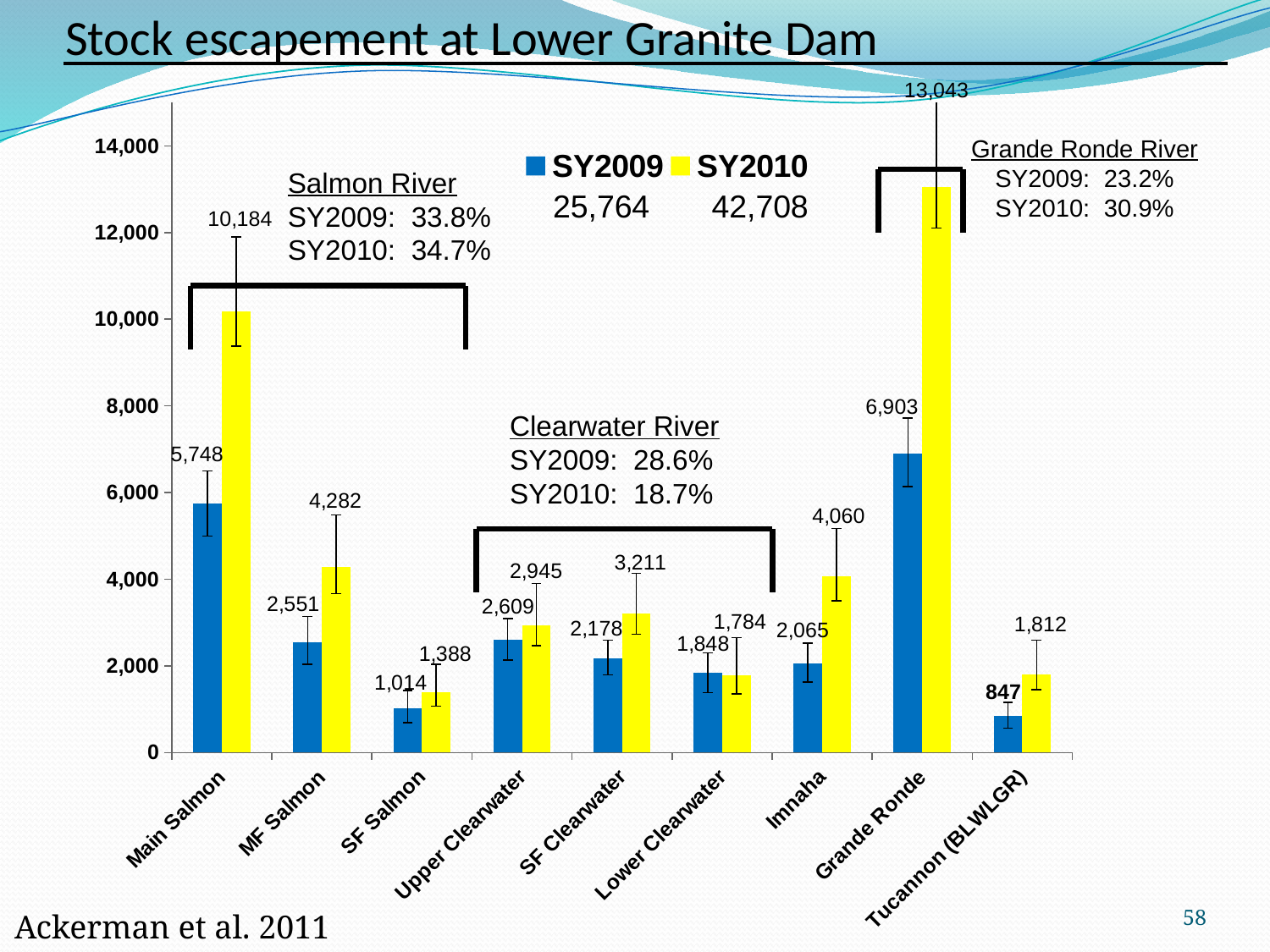
How many series does the legend list? 2 Is the SY2010 value for MF Salmon greater or less than 4,000? greater What is the difference between the SY2010 and SY2009 values for Main Salmon? 4,436 How many categories are shown on the x axis? 9 What is the SY2009 value for Tucannon (BLWLGR)? 847 Which category has the lowest SY2009 value? Tucannon (BLWLGR) What is the SY2009 value for Main Salmon? 5,748 Which category has the highest SY2010 value? Grande Ronde What is the SY2010 value for Imnaha? 4,060 Which is larger for Lower Clearwater, the SY2009 value or the SY2010 value? SY2009 What kind of chart is shown on the slide? bar chart What is the SY2010 value for Grande Ronde? 13,043